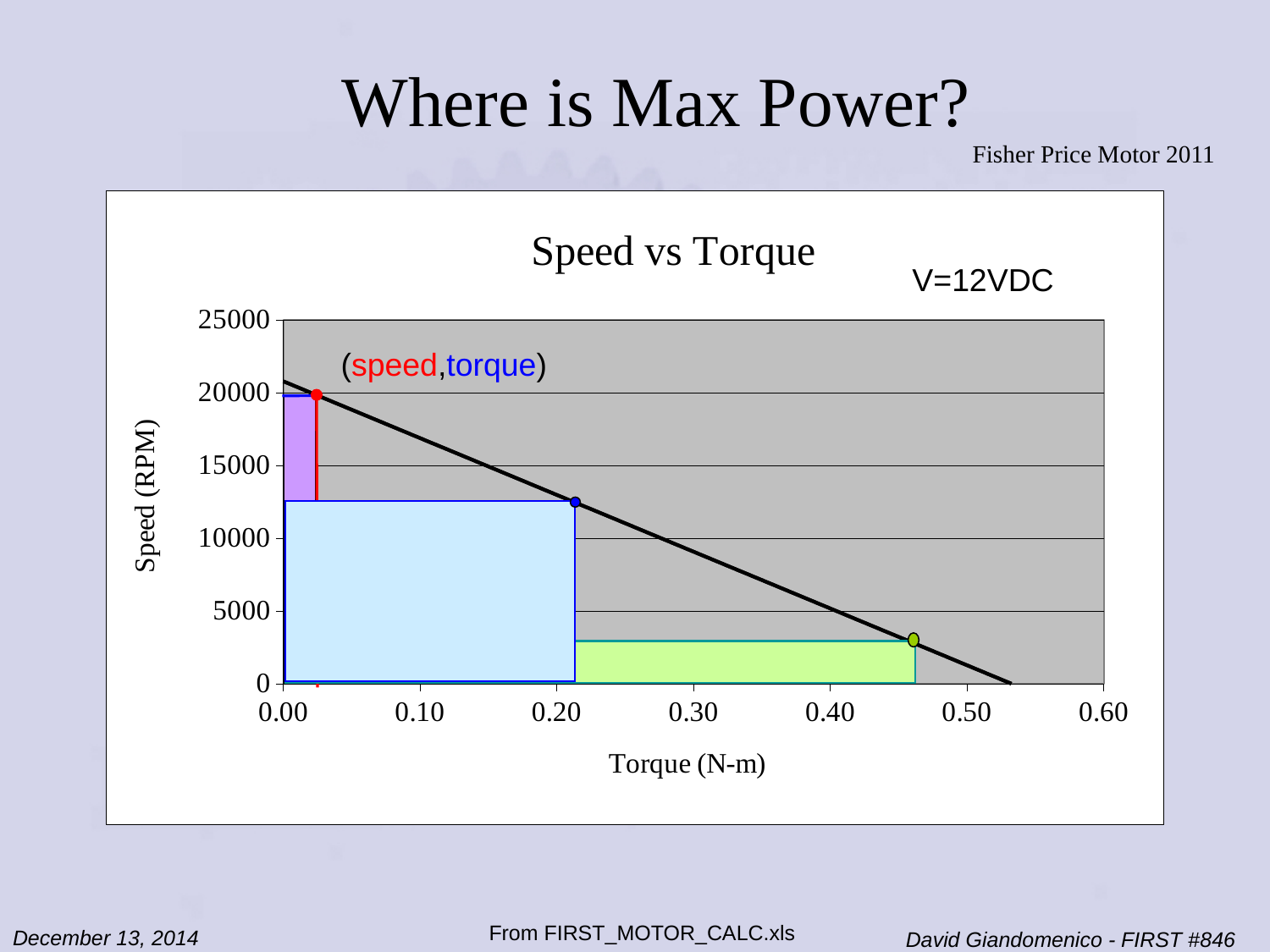
Is the speed at the blue marked point greater or less than 10000 RPM? greater Does speed rise or fall as torque increases along the x axis? fall What is the title of the chart? Speed vs Torque Is the torque at which the line reaches 0 RPM greater or less than 0.50 N-m? greater Is the speed at the green marked point greater or less than 5000 RPM? less How many marked points are shown on the speed-torque line? 3 Which is larger, the speed at the blue marked point or the speed at the green marked point? blue marked point Which marked point has the highest speed: the red, blue or green one? red What kind of chart is shown on the slide? line chart What is the label of the y axis? Speed (RPM)